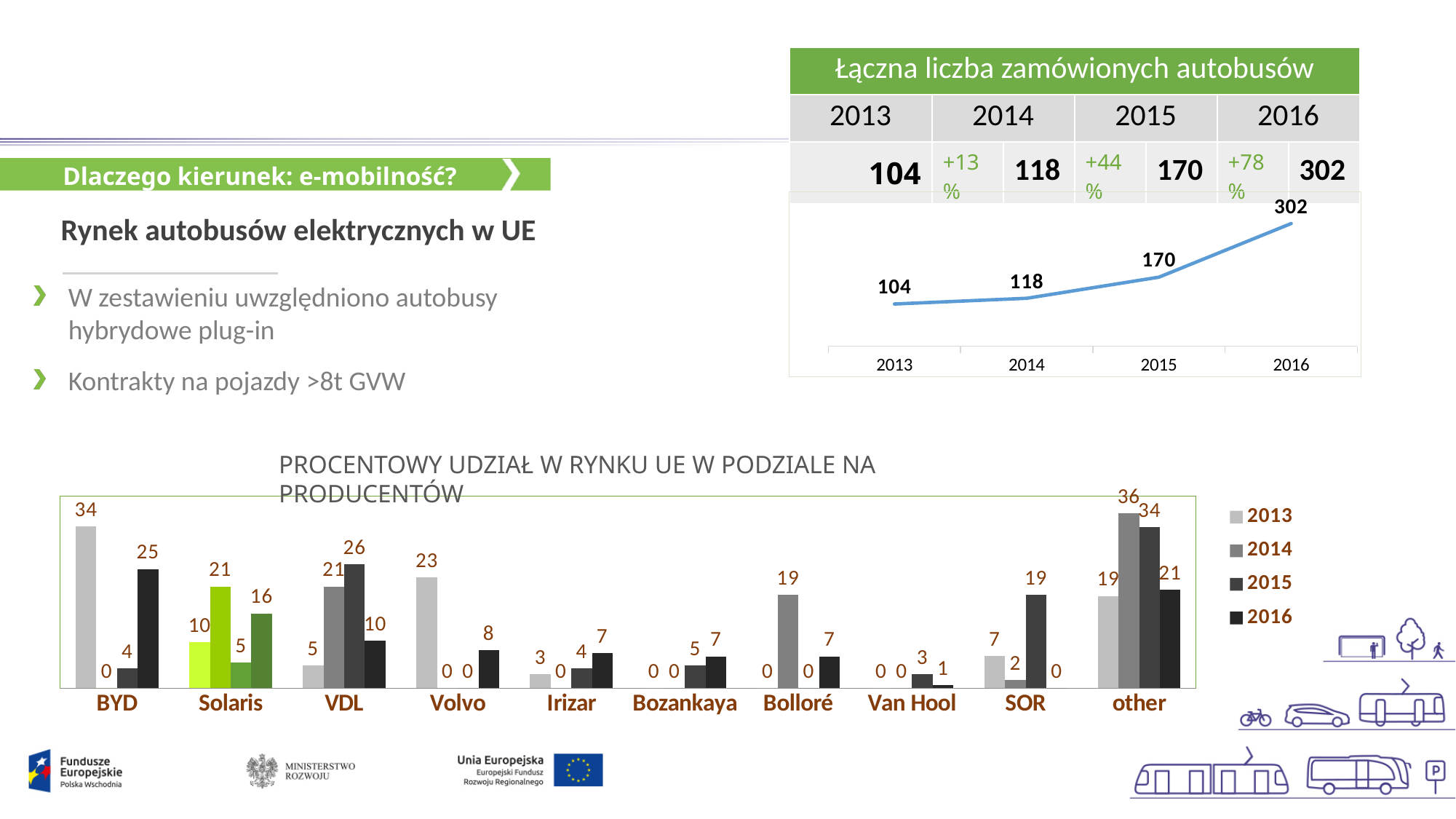
In the bar chart 'PROCENTOWY UDZIAŁ W RYNKU UE W PODZIALE NA PRODUCENTÓW', which is larger: Volvo in 2013 or Volvo in 2016? Volvo in 2013 In the bar chart 'PROCENTOWY UDZIAŁ W RYNKU UE W PODZIALE NA PRODUCENTÓW', how many manufacturer categories are shown on the x axis? 10 In the line chart titled 'Łączna liczba zamówionych autobusów', what is the value for 2016? 302 In the bar chart 'PROCENTOWY UDZIAŁ W RYNKU UE W PODZIALE NA PRODUCENTÓW', which category has the highest value for 2014? other In the bar chart 'PROCENTOWY UDZIAŁ W RYNKU UE W PODZIALE NA PRODUCENTÓW', which manufacturer has the highest value for 2013? BYD In the line chart titled 'Łączna liczba zamówionych autobusów', what is the difference between the 2016 and 2013 values? 198 In the line chart titled 'Łączna liczba zamówionych autobusów', how many data points are plotted? 4 In the bar chart 'PROCENTOWY UDZIAŁ W RYNKU UE W PODZIALE NA PRODUCENTÓW', how many series does the legend list? 4 In the line chart titled 'Łączna liczba zamówionych autobusów', do the values rise or fall from 2013 to 2016? rise In the bar chart 'PROCENTOWY UDZIAŁ W RYNKU UE W PODZIALE NA PRODUCENTÓW', what is the difference between the 2014 and 2013 values for Solaris? 11 In the bar chart 'PROCENTOWY UDZIAŁ W RYNKU UE W PODZIALE NA PRODUCENTÓW', what is the value for BYD in 2016? 25 In the bar chart 'PROCENTOWY UDZIAŁ W RYNKU UE W PODZIALE NA PRODUCENTÓW', what is the value for VDL in 2015? 26